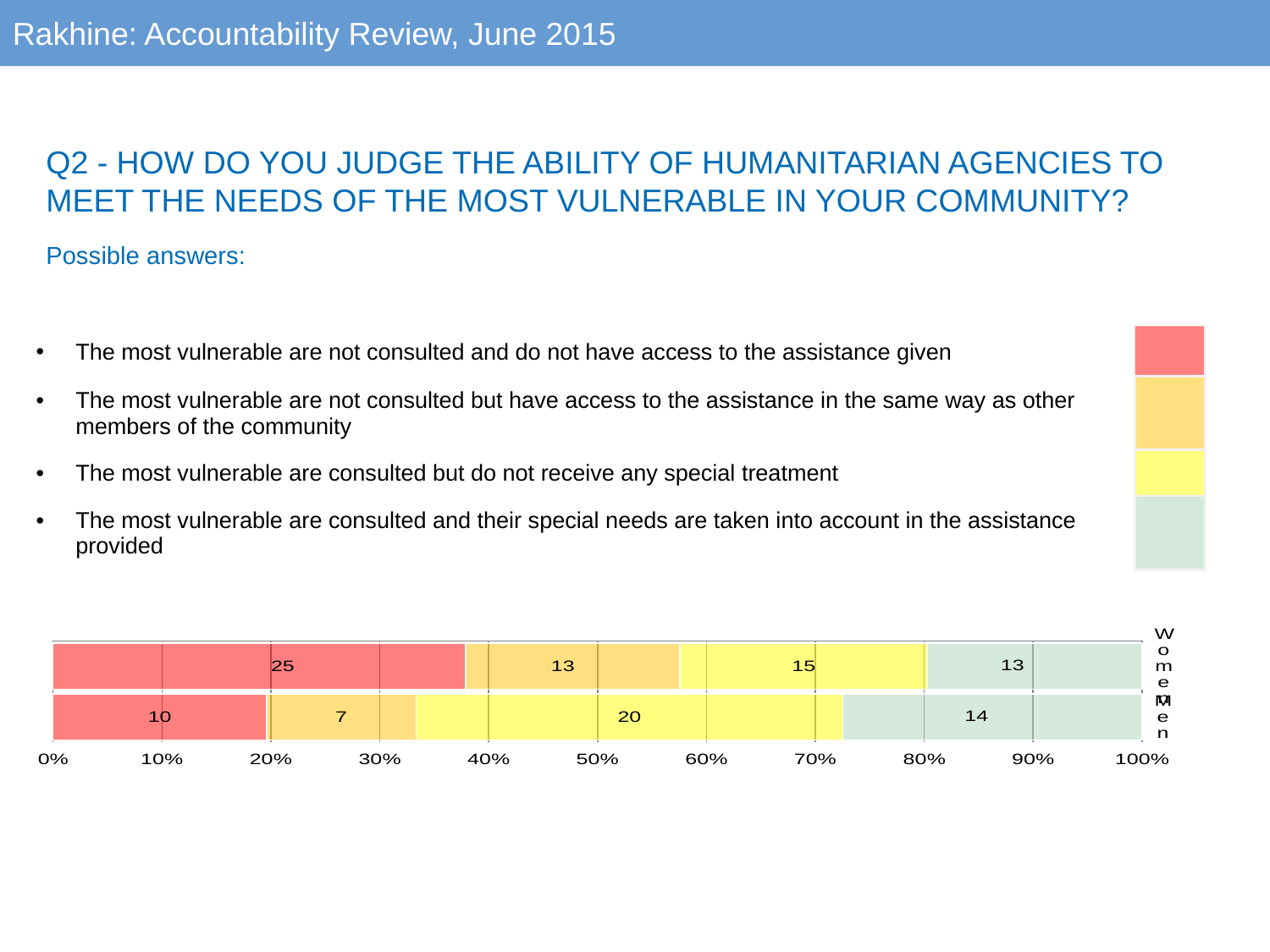
What type of chart is shown on the slide? bar chart What is the value of the green segment in the Men bar? 14 What is the value of the red segment in the Women bar? 25 How many bars (respondent groups) does the chart show? 2 What is the total of all segments in the Men bar? 51 Which segment has the highest value in the Women bar? the red segment (25) What is the total of all segments in the Women bar? 66 Which group has the larger yellow segment value, Women or Men? Men What is the value of the yellow segment in the Men bar? 20 Does the red segment of the Women bar end at a share greater or less than 30%? greater What is the difference between the red segment values for Women and Men? 15 What is the value of the orange segment in the Women bar? 13